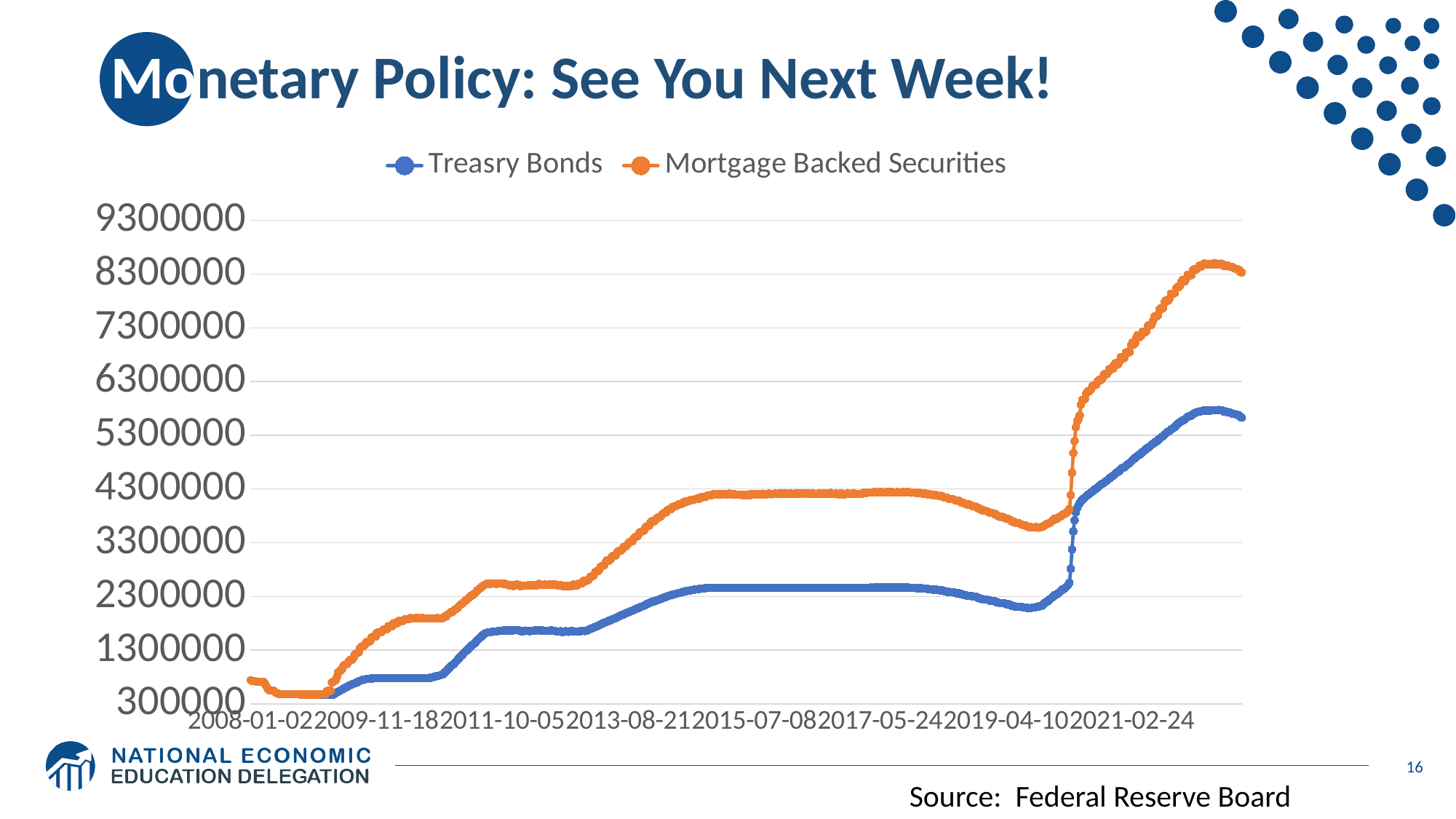
Is the value for Mortgage Backed Securities at the right end of the chart greater or less than 7300000? greater What is the source cited for the chart? Federal Reserve Board Is the value for Treasry Bonds at the right end of the chart greater or less than 6300000? less How many date labels are shown on the x axis? 8 Which series has the higher value at the right end of the chart, Treasry Bonds or Mortgage Backed Securities? Mortgage Backed Securities Do the Treasry Bonds values rise or fall between 2019-04-10 and 2021-02-24? rise How many series does the legend list? 2 What kind of chart is shown on the slide? line chart Is the value for Treasry Bonds at 2015-07-08 greater or less than 3300000? less Which series is drawn in orange? Mortgage Backed Securities